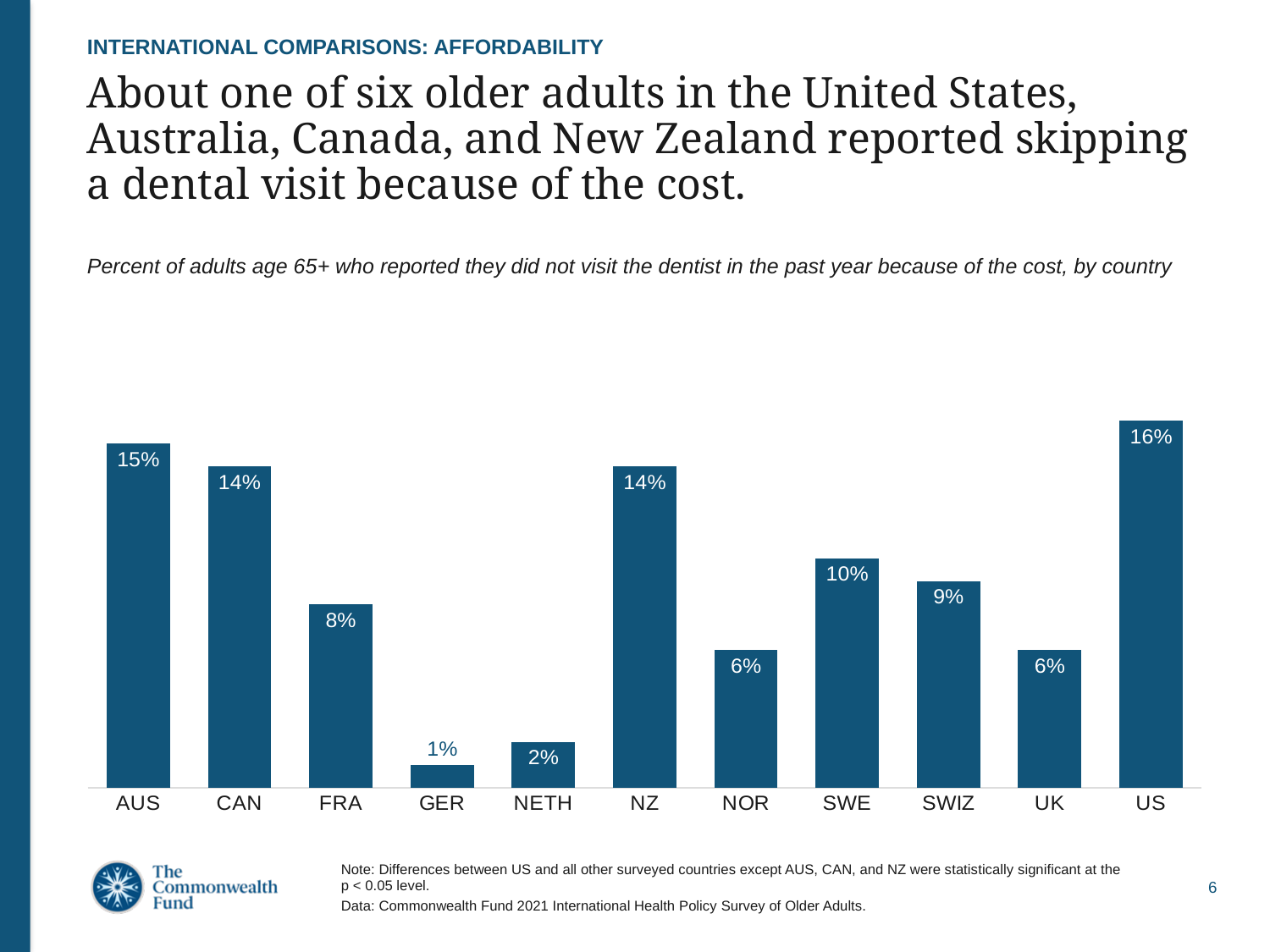
What is the difference between the values for the US and France (FRA)? 8% How many countries are shown on the chart? 11 What is the value shown for Germany (GER)? 1% Which has a higher value, Canada (CAN) or Sweden (SWE)? CAN Which two countries share the same value of 14%? CAN and NZ What type of chart is shown on the slide? Bar chart What is the difference between the values for Switzerland (SWIZ) and the UK? 3% Which country has the lowest value on the chart? GER Which country has the highest percentage of older adults who skipped a dental visit because of cost? US What is the value shown for Sweden (SWE)? 10% Which has a higher value, the Netherlands (NETH) or Norway (NOR)? NOR What percent of adults age 65+ in Australia (AUS) reported not visiting the dentist because of the cost? 15%